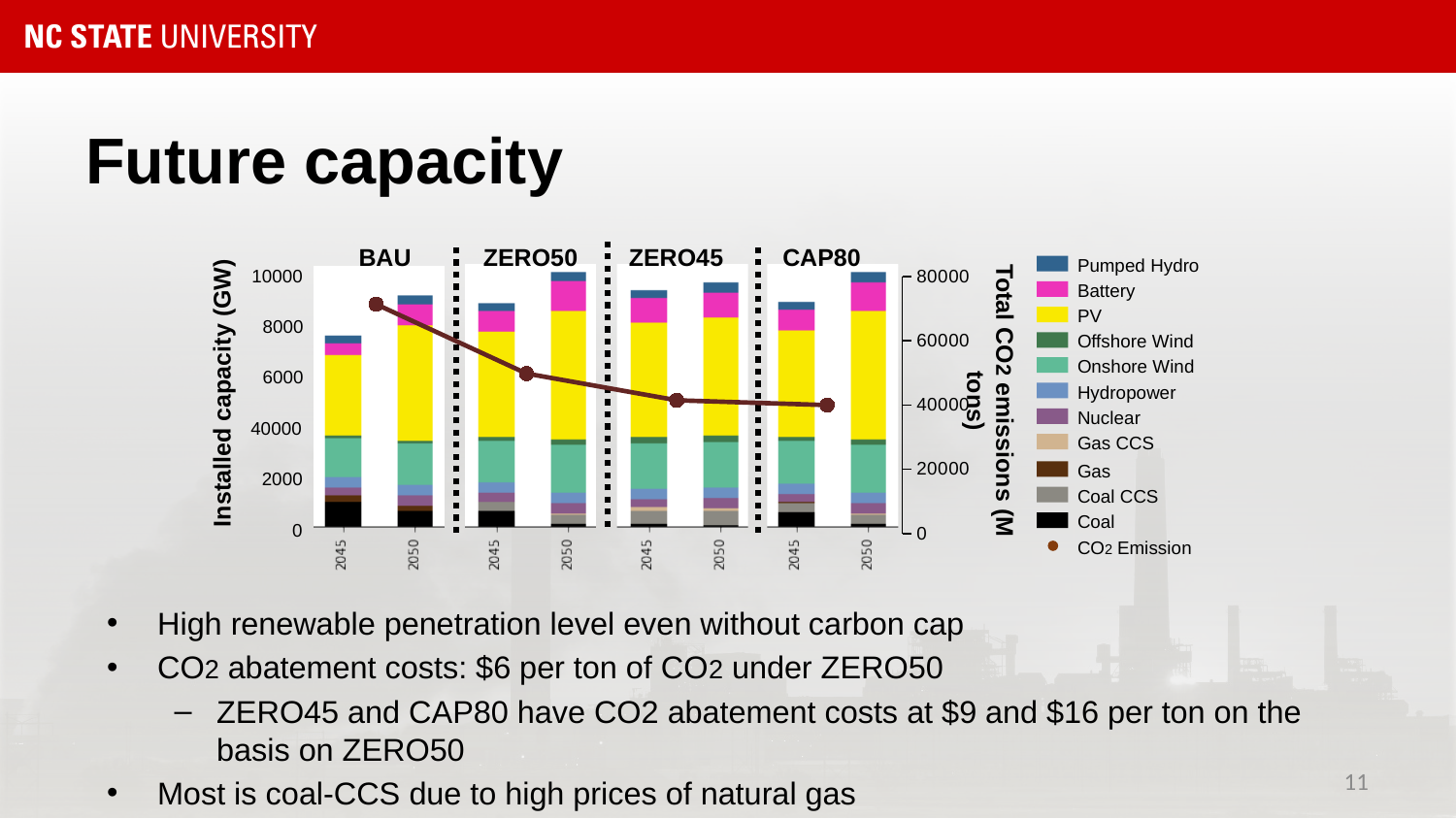
Is the CO2 emission value for BAU 2045 greater or less than 60000? greater Is the total installed capacity for BAU 2045 greater or less than 8000 GW? less What kind of chart is shown on the slide? Stacked bar chart with a line overlay What colour represents PV in the legend? Yellow How many scenarios are labelled across the top of the chart? 4 Is the CO2 emission value for ZERO50 2050 greater or less than 60000? less Which has the larger total installed capacity, BAU 2045 or ZERO50 2050? ZERO50 2050 Does the CO2 Emission line rise or fall from BAU 2045 to CAP80 2050? fall Which bar has the lowest total installed capacity? BAU 2045 How many bars are plotted in the chart? 8 How many entries does the chart legend list? 12